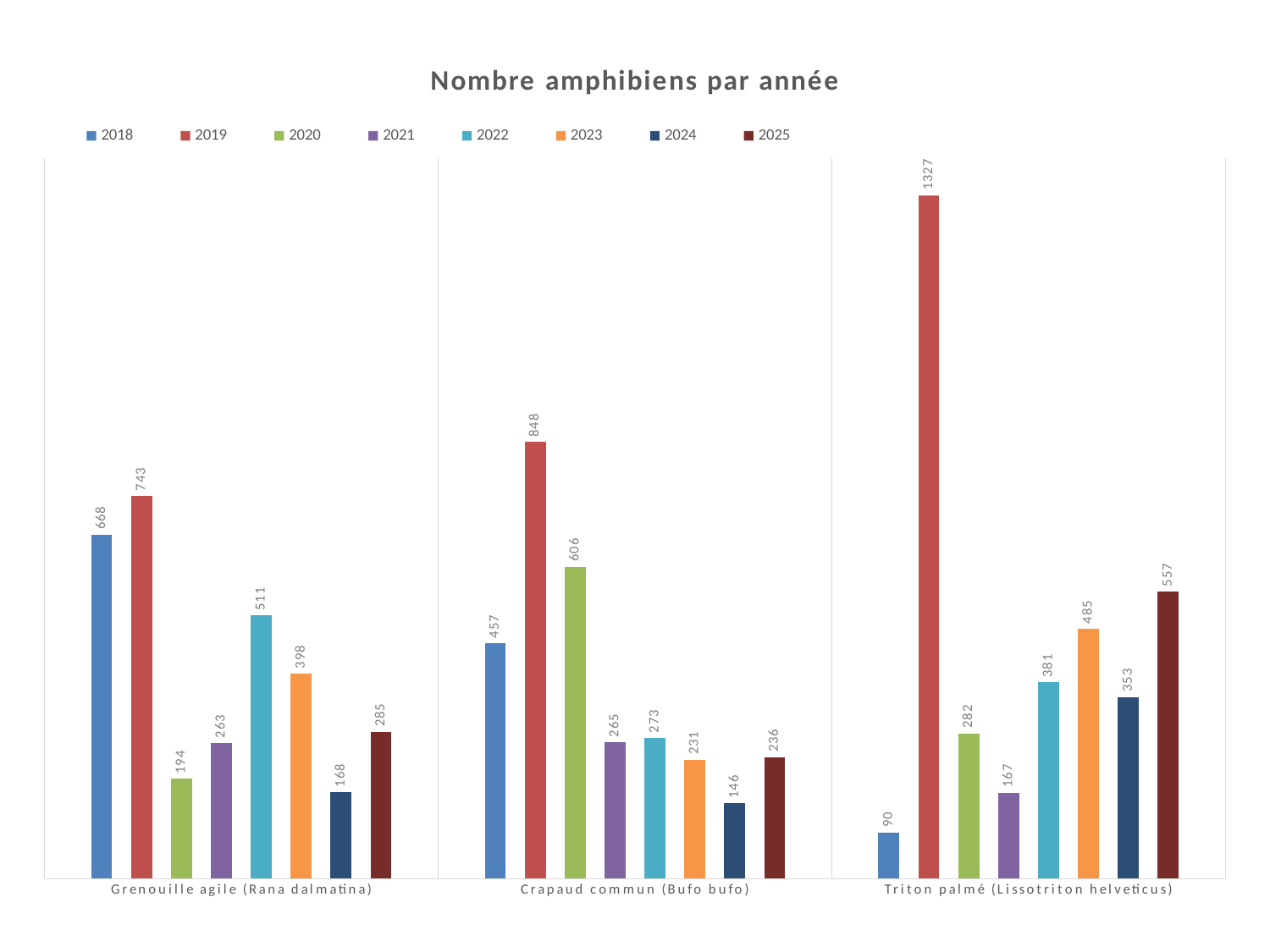
What is the title of the chart? Nombre amphibiens par année What is the value for Grenouille agile (Rana dalmatina) in 2019? 743 How many series does the legend list? 8 How many species categories are shown on the x axis? 3 What is the difference between the 2025 and 2024 values for Triton palmé (Lissotriton helveticus)? 204 Which year has the lowest value for Crapaud commun (Bufo bufo)? 2024 What kind of chart is shown on the slide? bar chart Which year has the highest value for Triton palmé (Lissotriton helveticus)? 2019 What is the value for Crapaud commun (Bufo bufo) in 2020? 606 What is the value for Triton palmé (Lissotriton helveticus) in 2018? 90 What is the difference between the 2019 and 2018 values for Crapaud commun (Bufo bufo)? 391 Which is larger for Grenouille agile (Rana dalmatina): the 2022 value or the 2023 value? 2022